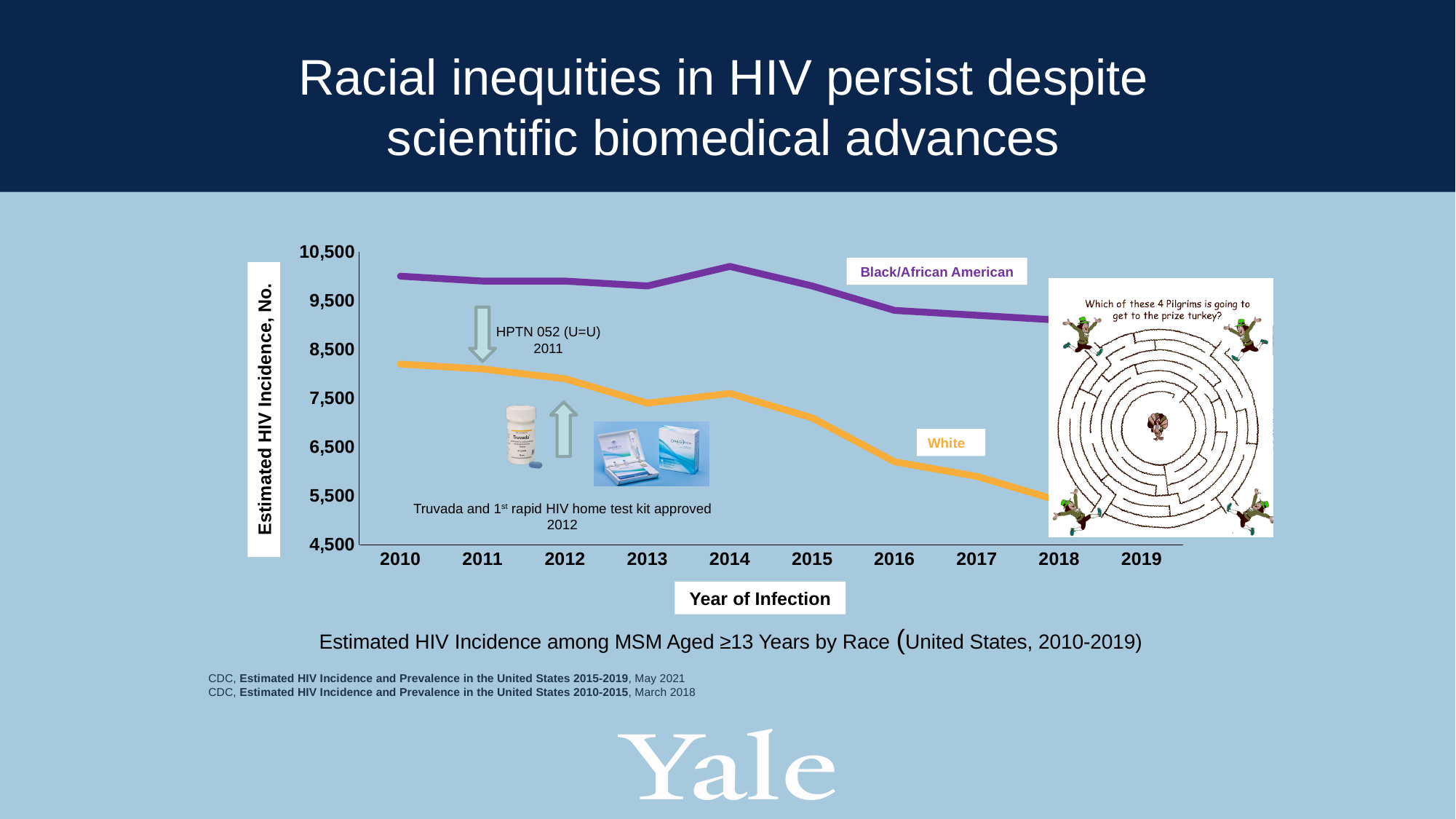
What colour is the line for the White series? orange Does the White series rise or fall from 2010 to 2018? fall How many series does the chart show? 2 Is the value for Black/African American in 2010 greater or less than 9,500? greater What is the title of the x axis? Year of Infection Which series has the higher value in 2018, Black/African American or White? Black/African American Is the value for Black/African American in 2014 greater or less than 9,500? greater Is the value for White in 2010 greater or less than 8,500? less What kind of chart is shown on the slide? line chart How many year labels are shown on the x axis? 10